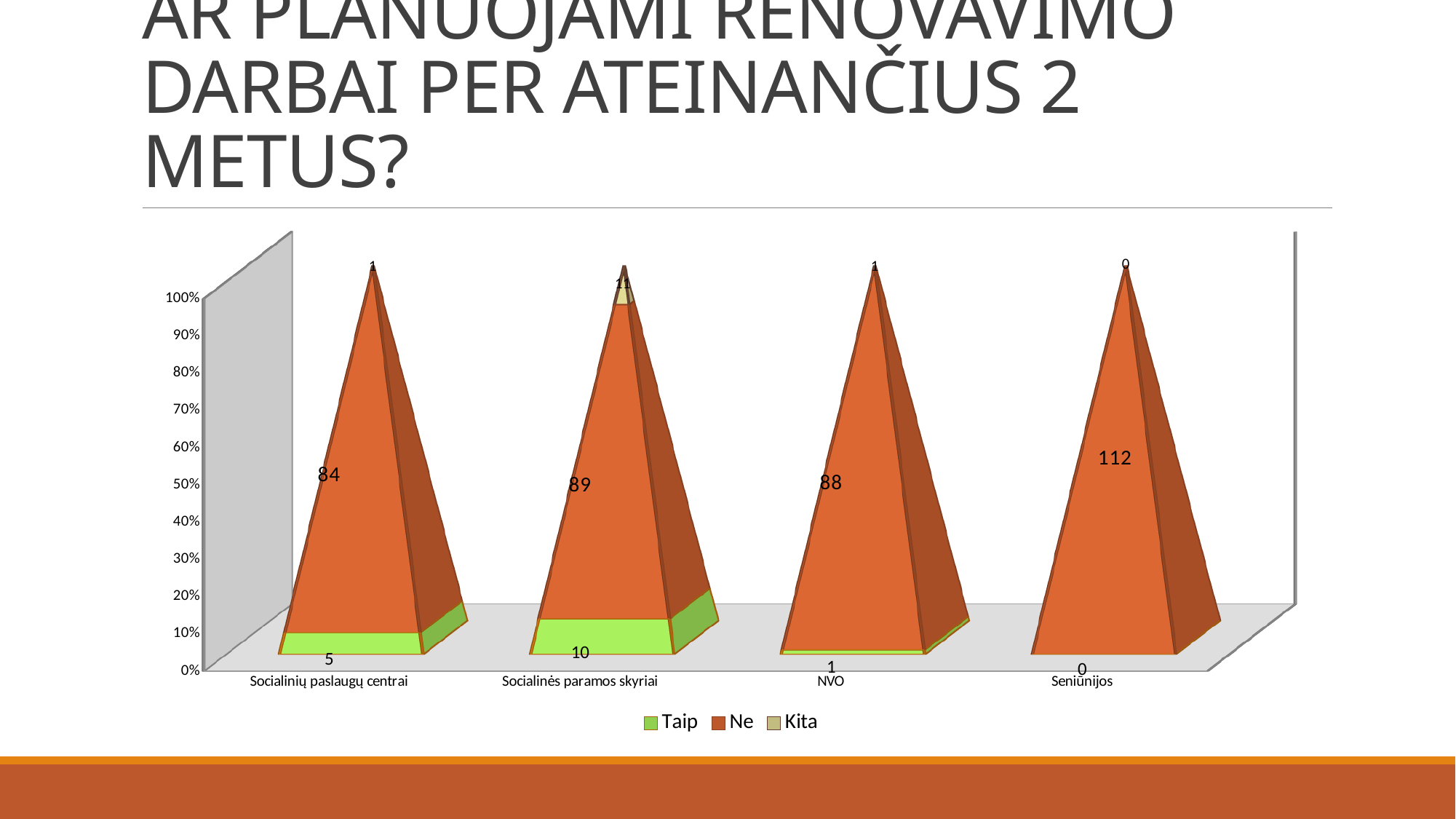
Which category has the lowest value in the Taip series? Seniūnijos What is the value of the Taip series for Socialinių paslaugų centrai? 5 What is the difference between the Ne values for Socialinės paramos skyriai and Socialinių paslaugų centrai? 5 What is the value of the Taip series for Socialinės paramos skyriai? 10 Which has a larger Taip value, Socialinės paramos skyriai or Socialinių paslaugų centrai? Socialinės paramos skyriai How many series does the legend list? 3 What kind of chart is shown on the slide? Stacked bar chart What is the total of all series for Seniūnijos? 112 What is the value of the Ne series for NVO? 88 What is the value of the Ne series for Seniūnijos? 112 Which category has the highest value in the Ne series? Seniūnijos How many categories are shown on the x axis? 4